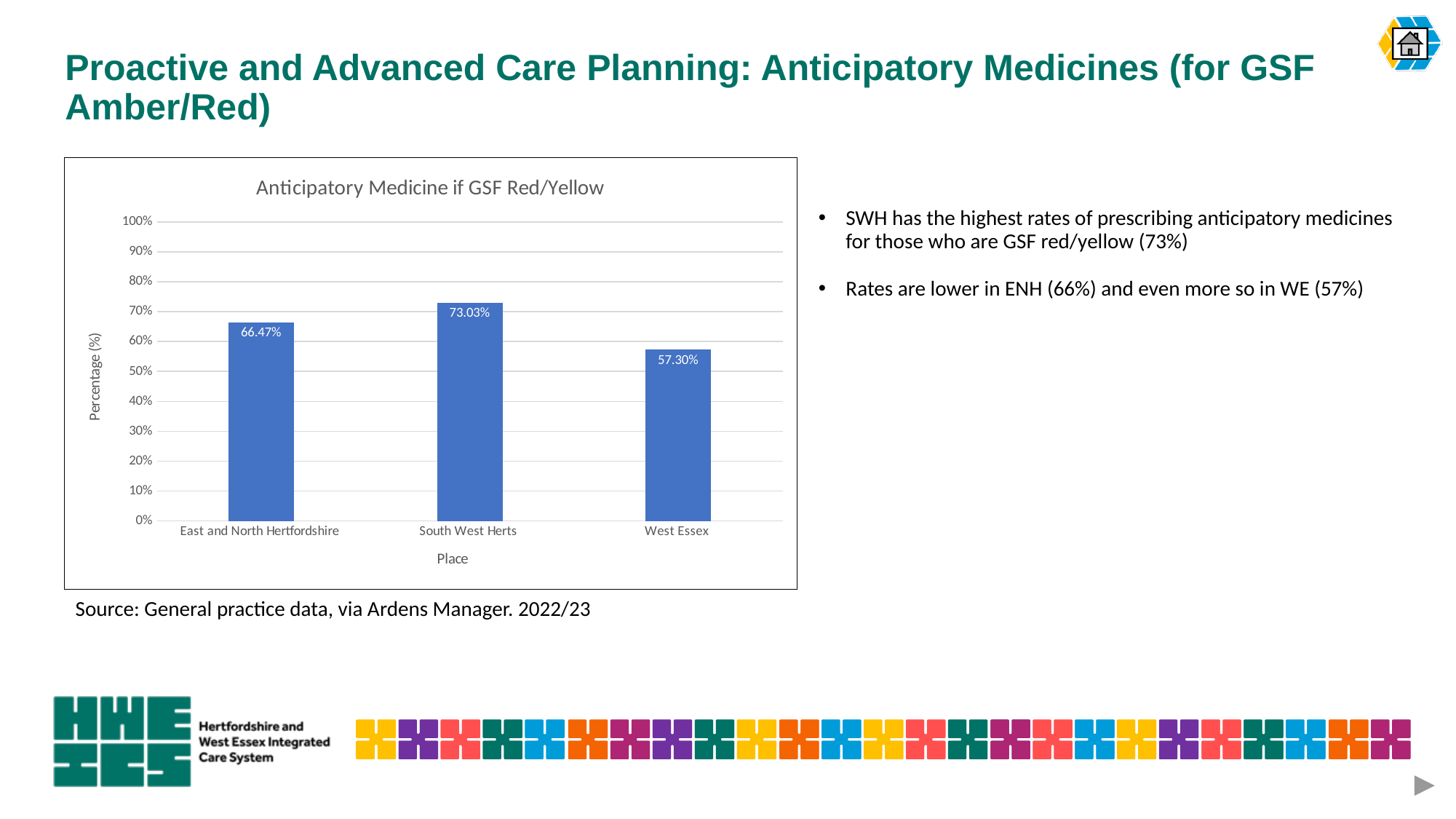
What is the difference between the values for South West Herts and West Essex? 15.73% Which place has the lowest value? West Essex Which is larger, the value for East and North Hertfordshire or the value for West Essex? East and North Hertfordshire What is the value for East and North Hertfordshire? 66.47% What is the difference between the values for East and North Hertfordshire and West Essex? 9.17% Is the value for West Essex greater or less than 60%? less How many places are shown on the chart? 3 What is the value for South West Herts? 73.03% What is the value for West Essex? 57.30% What is the title of the chart? Anticipatory Medicine if GSF Red/Yellow Which place has the highest value? South West Herts What kind of chart is shown on the slide? bar chart